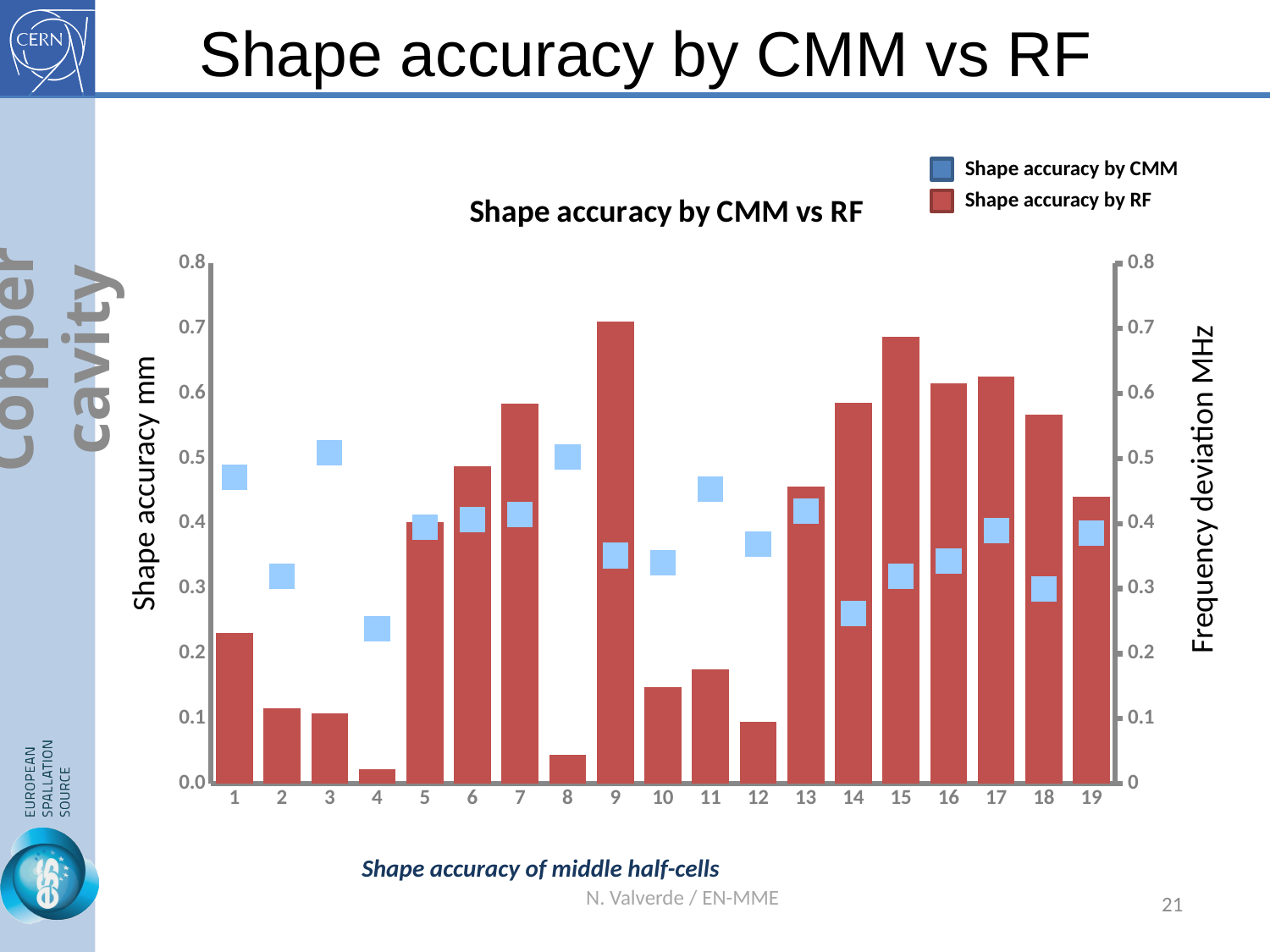
Which category has the lowest 'Shape accuracy by RF' bar? 4 What kind of chart is used for the 'Shape accuracy by RF' series? bar chart Which category has the highest 'Shape accuracy by RF' bar? 9 Is the 'Shape accuracy by CMM' value for category 11 greater or less than 0.4? greater Is the 'Shape accuracy by RF' value for category 8 greater or less than 0.1? less What is the title of the chart? Shape accuracy by CMM vs RF Which has the larger 'Shape accuracy by RF' value, category 6 or category 7? 7 How many categories are shown on the x axis? 19 Is the 'Shape accuracy by RF' value for category 14 greater or less than 0.5? greater How many series does the legend list? 2 What is the title of the right-hand vertical axis? Frequency deviation MHz